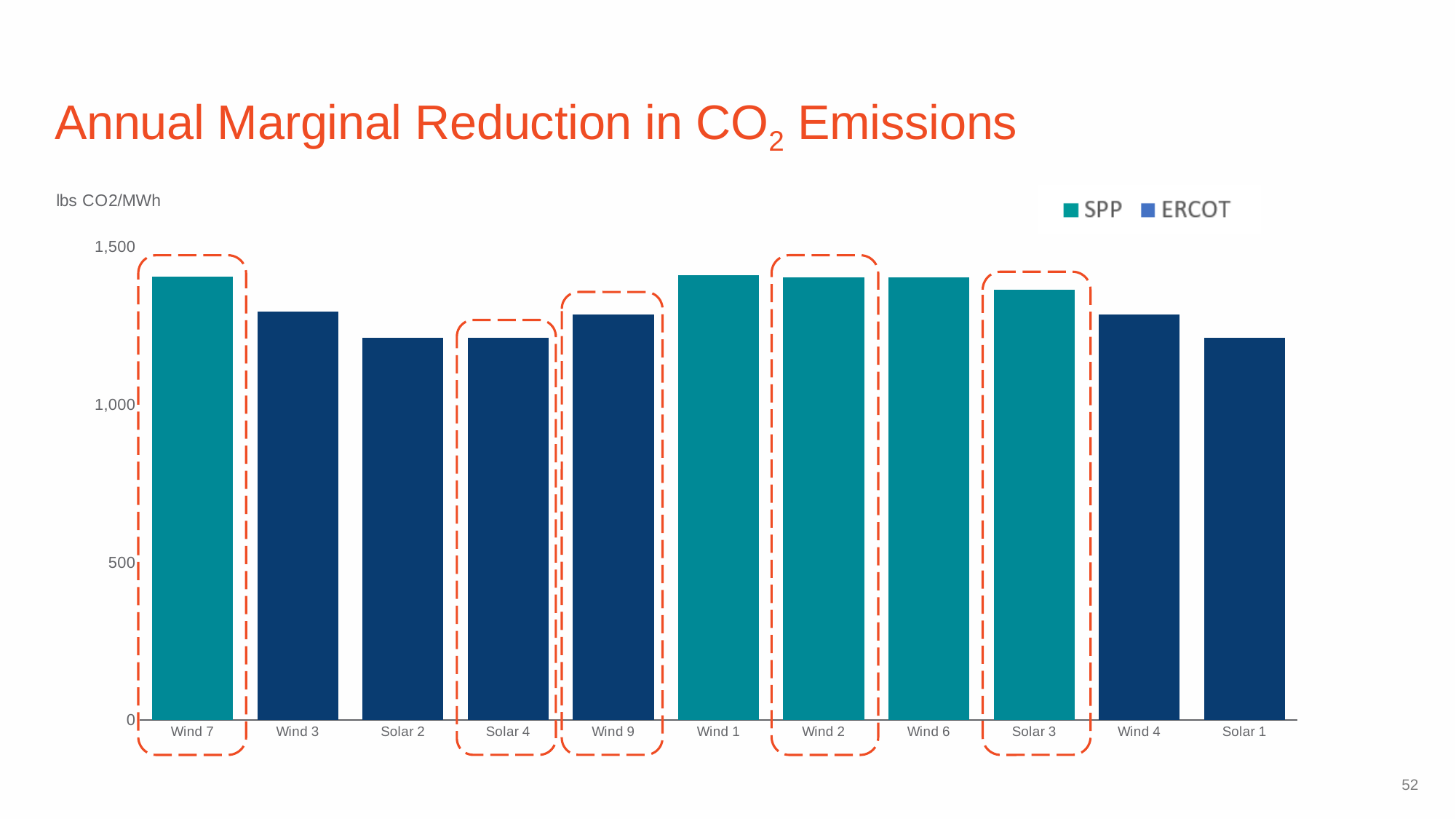
What is the title of the chart on the slide? Annual Marginal Reduction in CO2 Emissions According to the legend, which series does the Wind 7 bar belong to? SPP What kind of chart is shown on the slide? bar chart Is the value for Solar 1 greater or less than 500? greater Which is larger, the value for Solar 3 or the value for Solar 1? Solar 3 Is the value for Wind 7 greater or less than 1,000? greater How many categories are shown on the x axis of the chart? 11 Is the value for Wind 9 greater or less than 1,000? greater Which is larger, the value for Wind 1 or the value for Wind 4? Wind 1 How many series does the legend list? 2 Which is larger, the value for Wind 7 or the value for Solar 2? Wind 7